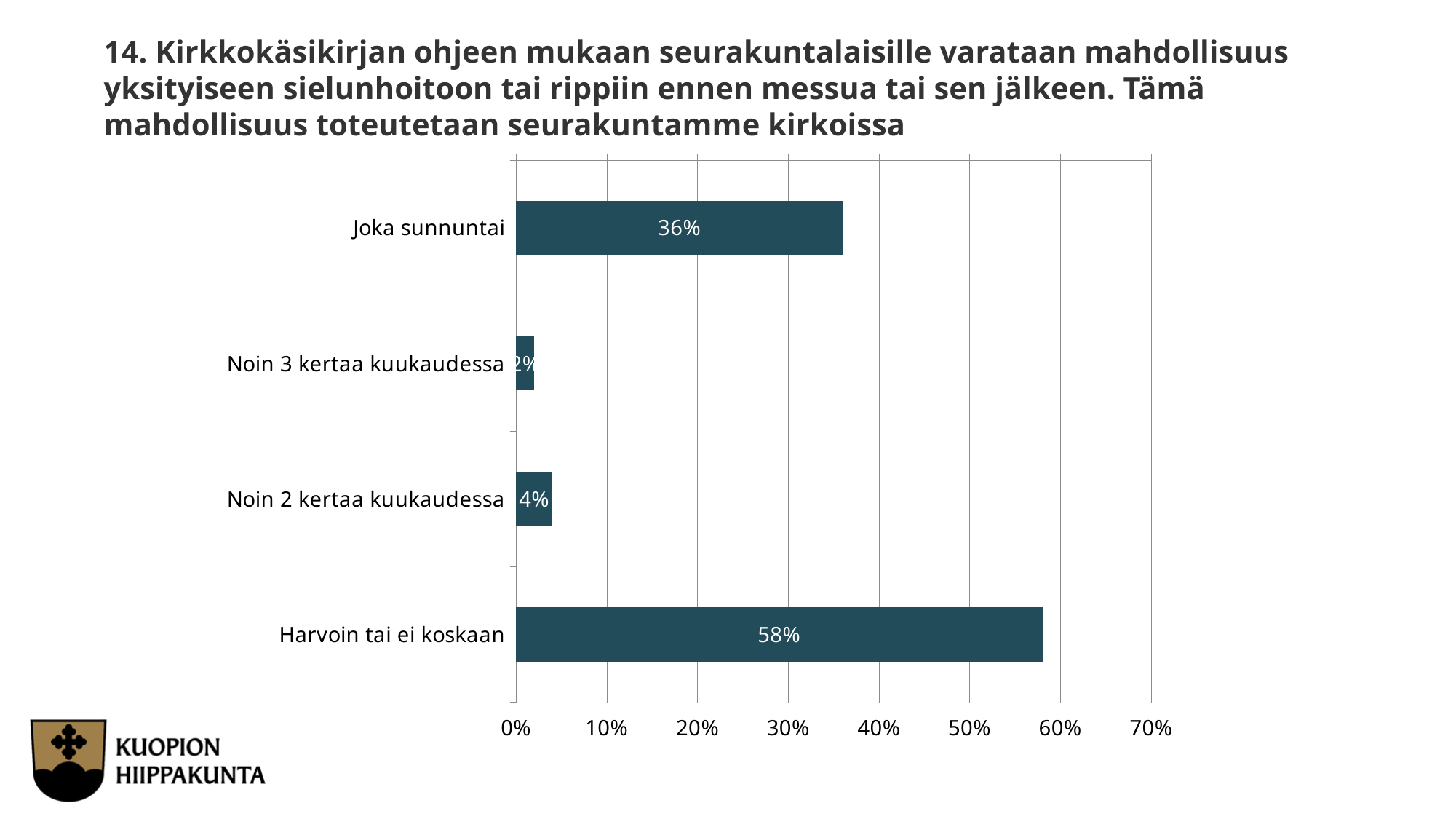
What kind of chart is shown on the slide? bar chart What is the value for "Noin 2 kertaa kuukaudessa"? 4% What is the difference between "Harvoin tai ei koskaan" and "Joka sunnuntai"? 22 percentage points What is the value for "Noin 3 kertaa kuukaudessa"? 2% Which category has the highest value? Harvoin tai ei koskaan What is the highest value shown on the x axis? 70% What is the value for "Joka sunnuntai"? 36% What is the value for "Harvoin tai ei koskaan"? 58% How many categories are shown in the chart? 4 Which category has the lowest value? Noin 3 kertaa kuukaudessa Is the value for "Joka sunnuntai" greater or less than 40%? less Which is larger: "Noin 2 kertaa kuukaudessa" or "Noin 3 kertaa kuukaudessa"? Noin 2 kertaa kuukaudessa